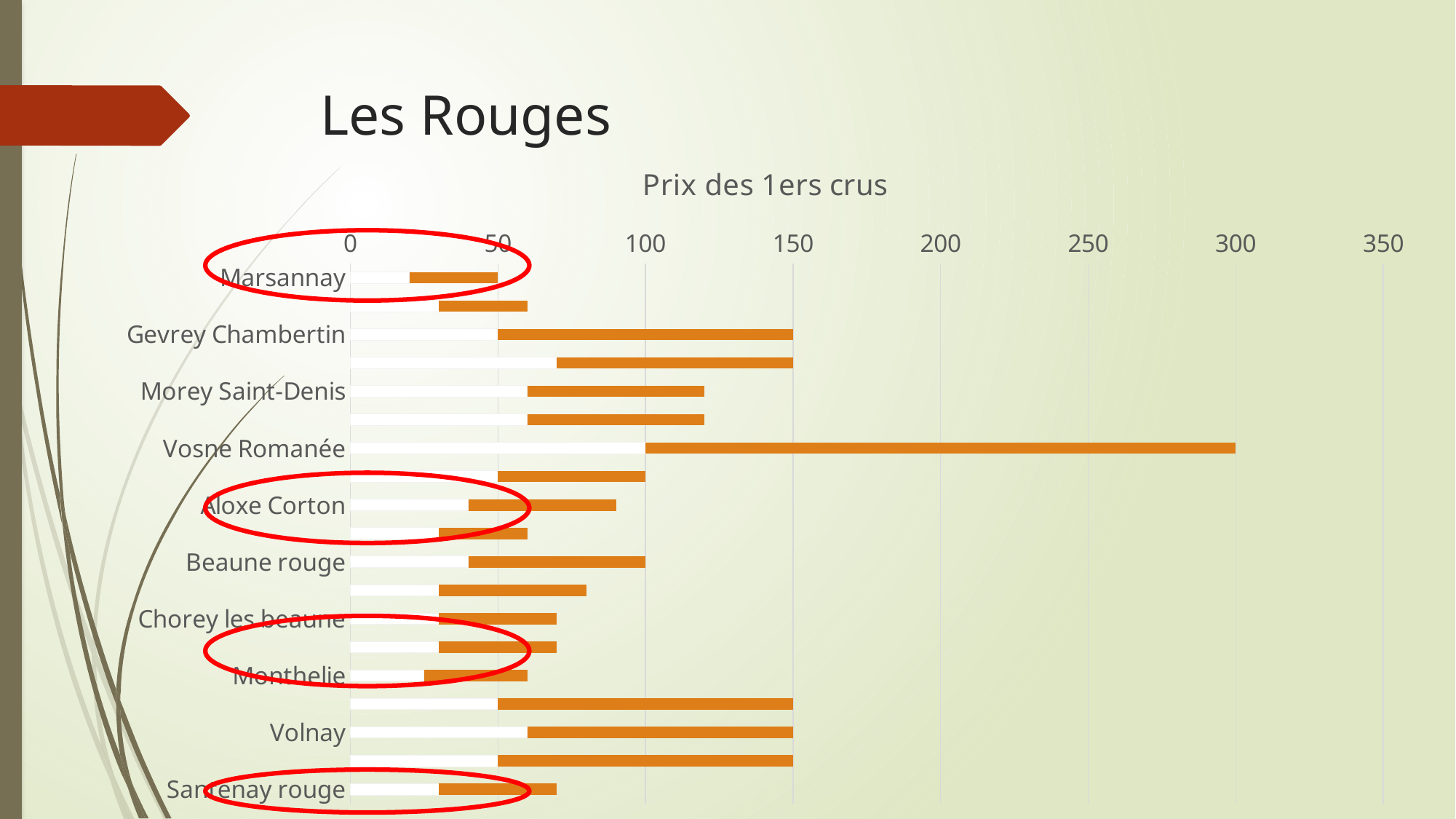
At what value does the Vosne Romanée bar start? 100 At what value does the Vosne Romanée bar end? 300 At what value does the Gevrey Chambertin bar end? 150 What is the title of the chart? Prix des 1ers crus Is the value for Vosne Romanée greater or less than 250? greater Which is higher, the price for Gevrey Chambertin or for Chorey les beaune? Gevrey Chambertin Is the value for Morey Saint-Denis greater or less than 150? less Is the value for Aloxe Corton greater or less than 100? less Which labelled category has the lowest upper price on the chart? Marsannay What is the highest value shown on the horizontal axis? 350 Which category has the highest price on the chart? Vosne Romanée What kind of chart is shown on the slide? bar chart